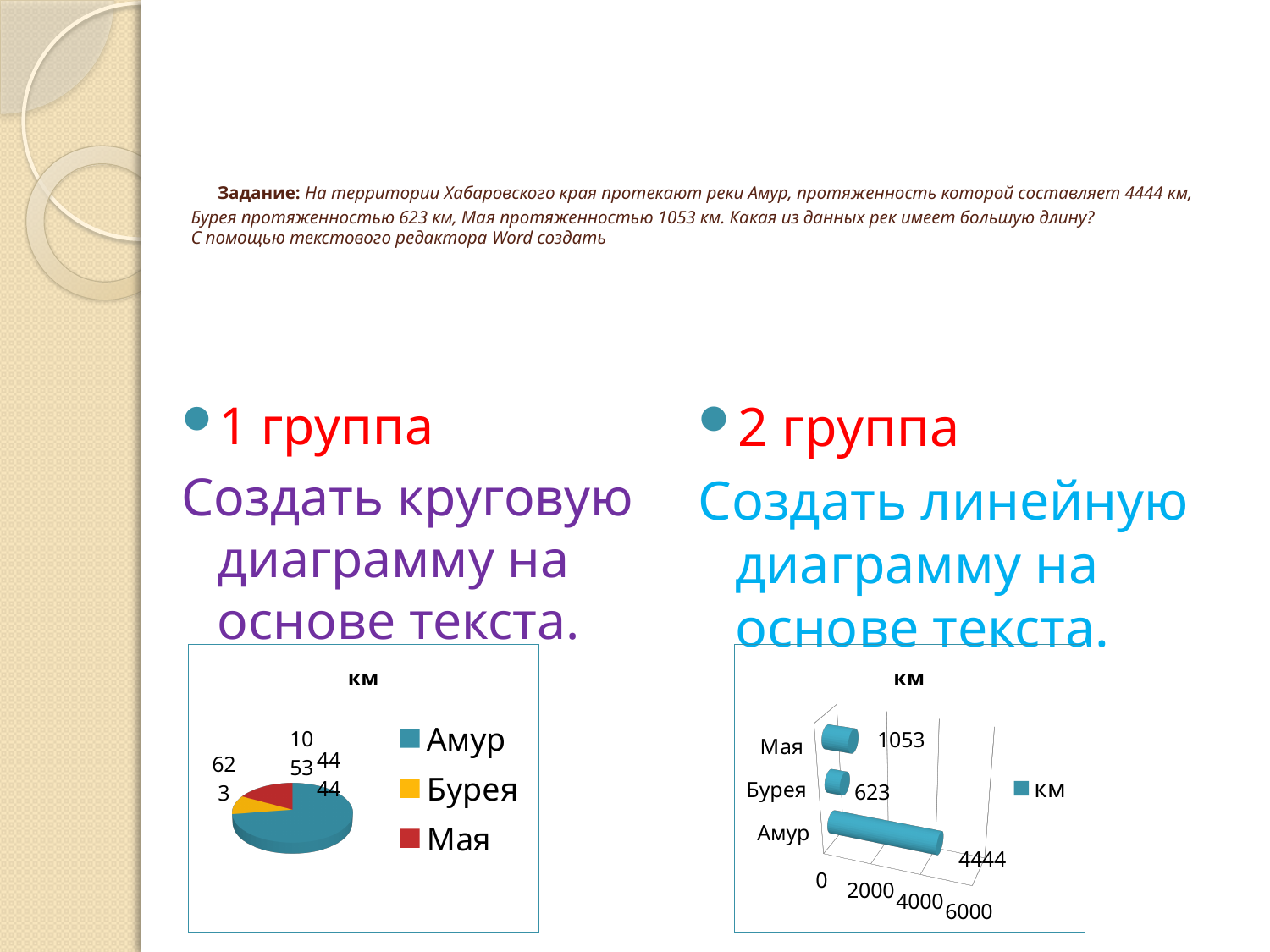
In the bar chart on the right, what is the difference between the values for Амур and Мая? 3391 What kind of chart is the chart on the left side of the slide? pie chart In the pie chart on the left, which category has the largest slice? Амур In the bar chart on the right, which category has the highest value? Амур In the bar chart on the right, what is the value for Бурея? 623 In the bar chart on the right, what is the value for Амур? 4444 In the bar chart on the right, is the value for Амур greater or less than 4000? greater What kind of chart is the chart on the right side of the slide? bar chart In the bar chart on the right, which is larger, the value for Мая or the value for Бурея? Мая How many categories are shown in the bar chart on the right? 3 In the bar chart on the right, what is the value for Мая? 1053 In the bar chart on the right, which category has the lowest value? Бурея